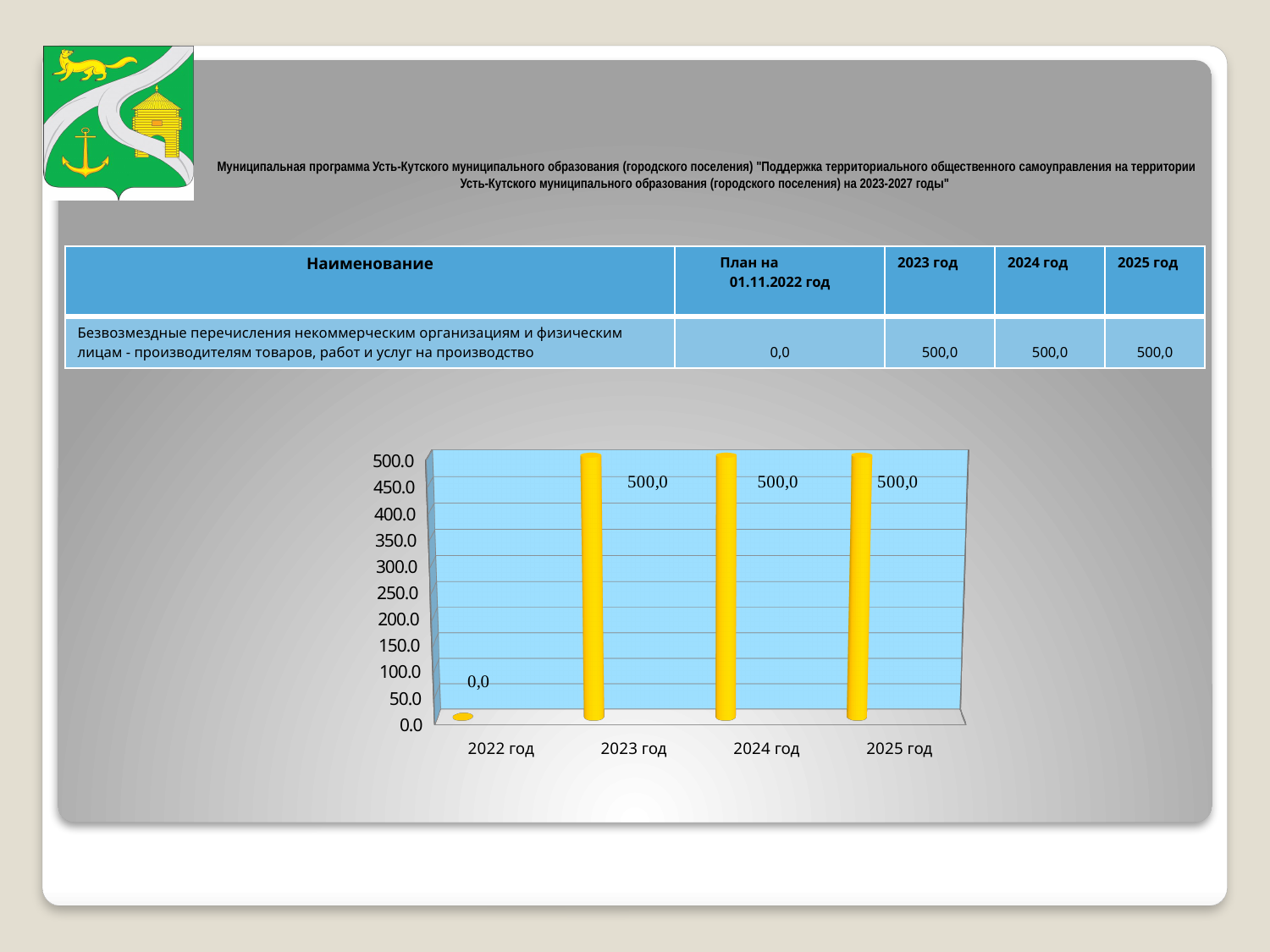
Which is larger, the value for 2024 год or the value for 2022 год? 2024 год What kind of chart is shown on the slide? bar chart Which category has the lowest value in the chart? 2022 год What is the value for 2022 год in the chart? 0,0 What is the value for 2025 год in the chart? 500,0 Is the value for 2024 год greater or less than 250.0? greater What is the value for 2023 год in the chart? 500,0 What is the highest tick value shown on the vertical axis of the chart? 500.0 What is the difference between the values for 2023 год and 2022 год? 500,0 What colour are the bars in the chart? yellow How many categories are shown on the x axis of the chart? 4 Do the values rise or fall from 2022 год to 2023 год? rise